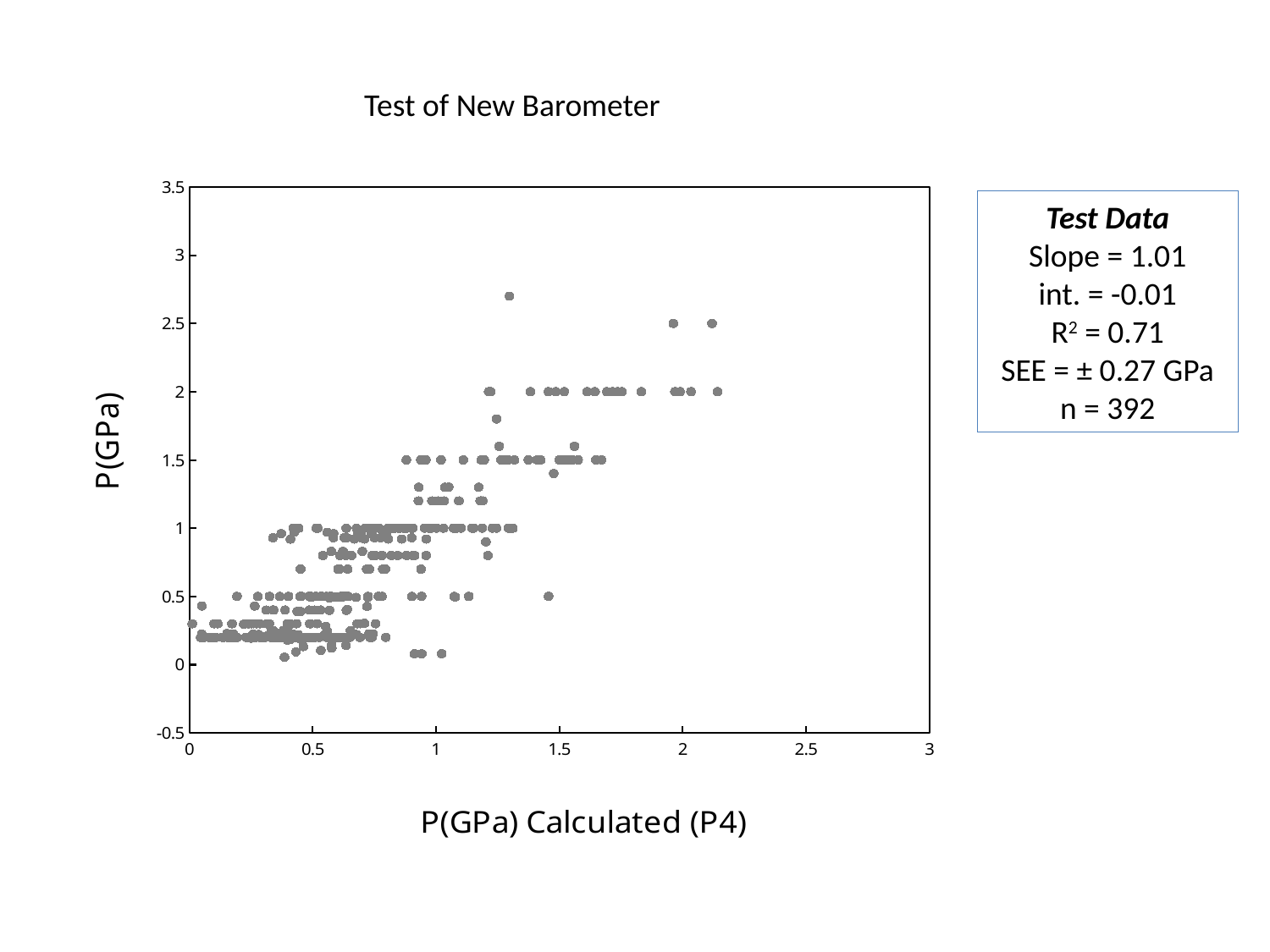
Is the largest P(GPa) Calculated (P4) value among the plotted points greater or less than 2.5? less According to the text box, how many data points (n) are in the test data? 392 Do the plotted P(GPa) values generally rise or fall as P(GPa) Calculated (P4) increases? rise What is the maximum value shown on the x axis? 3 What kind of chart is shown on the slide? scatter plot Is the highest plotted P(GPa) value greater or less than 2.5? greater Is the highest plotted P(GPa) value greater or less than 3? less What is the label of the x axis? P(GPa) Calculated (P4) What slope is reported for the test data? 1.01 What is the title of the chart? Test of New Barometer What R² value is reported for the test data? 0.71